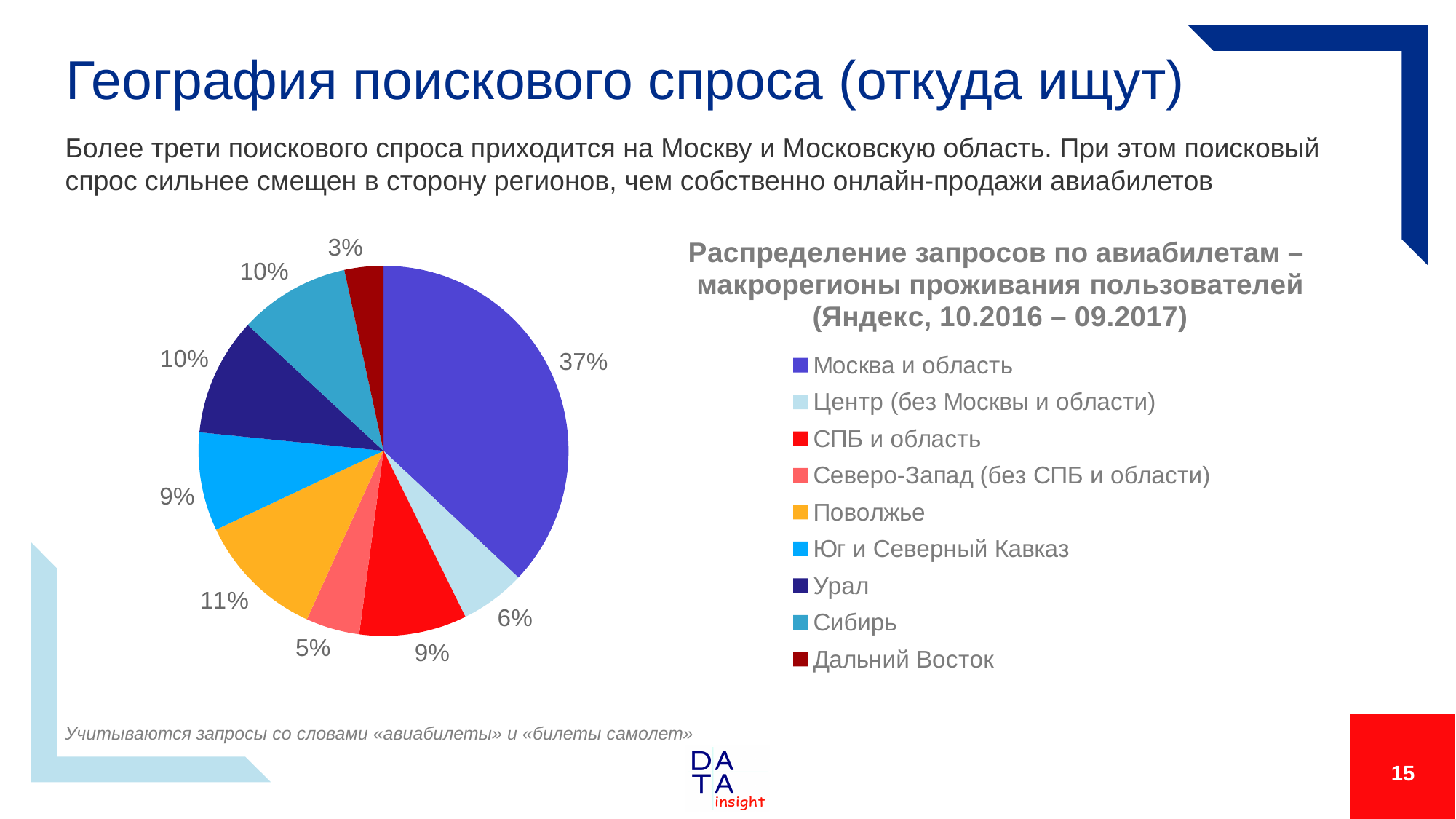
Which macroregion has the largest share of requests? Москва и область Which has a larger share: СПБ и область or Северо-Запад (без СПБ и области)? СПБ и область How many macroregions are listed in the legend? 9 What share of requests comes from Дальний Восток? 3% What is the combined share of Урал and Сибирь? 20% What share of requests comes from Поволжье? 11% What is the difference in share between Москва и область and Поволжье? 26 percentage points What kind of chart is shown on the slide? Pie chart Which macroregion has the smallest share of requests? Дальний Восток What colour is the slice for Поволжье? Orange What share of requests comes from Центр (без Москвы и области)? 6% What share of requests comes from Москва и область? 37%